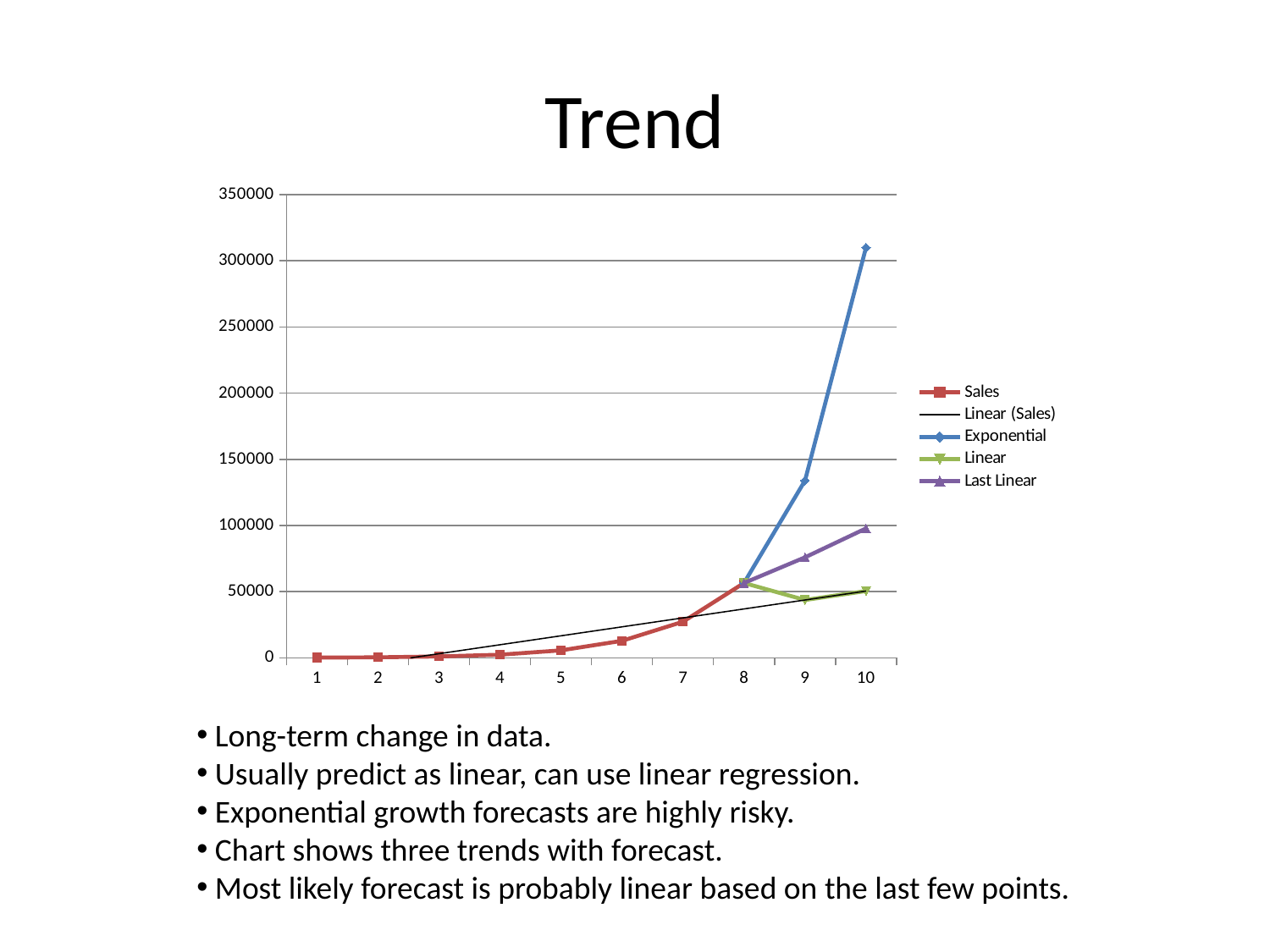
How many points are there along the x axis? 10 Do the Sales values rise or fall from x = 1 to x = 8? rise Is the Exponential value at x = 10 greater or less than 250000? greater Is the Sales value at x = 7 greater or less than 50000? less Which series has the highest value at x = 10? Exponential What kind of chart is shown on the slide? line chart Which of the forecast series (Exponential, Linear, Last Linear) has the lowest value at x = 10? Linear What is the title of the slide containing the chart? Trend Is the Exponential value at x = 9 greater or less than 150000? less How many series does the legend list? 5 At x = 10, which is larger: the Exponential value or the Last Linear value? Exponential